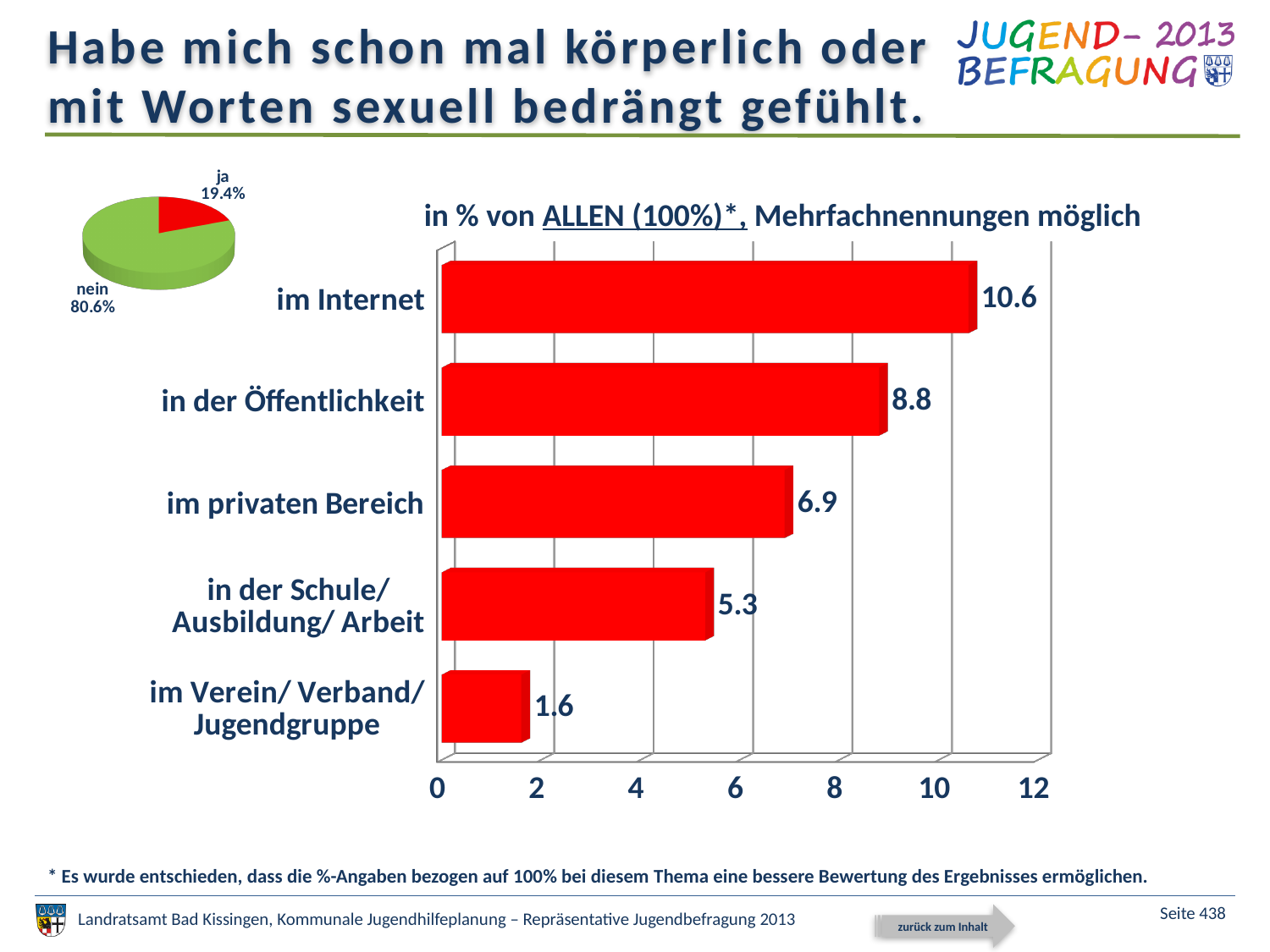
In the pie chart, what share is labelled 'nein'? 80.6% What kind of chart is the chart on the left side of the slide? pie chart In the bar chart, is the value for 'in der Öffentlichkeit' greater or less than 8? greater What kind of chart is the chart on the right side of the slide? bar chart How many categories does the bar chart show? 5 In the bar chart, which is larger: the value for 'im privaten Bereich' or 'in der Schule/ Ausbildung/ Arbeit'? im privaten Bereich In the pie chart, what share is labelled 'ja'? 19.4% In the bar chart, what is the difference between the values for 'in der Öffentlichkeit' and 'im privaten Bereich'? 1.9 In the bar chart, what is the value for 'im Internet'? 10.6 In the bar chart, what is the value for 'in der Schule/ Ausbildung/ Arbeit'? 5.3 In the bar chart, which category has the highest value? im Internet In the bar chart, which category has the lowest value? im Verein/ Verband/ Jugendgruppe